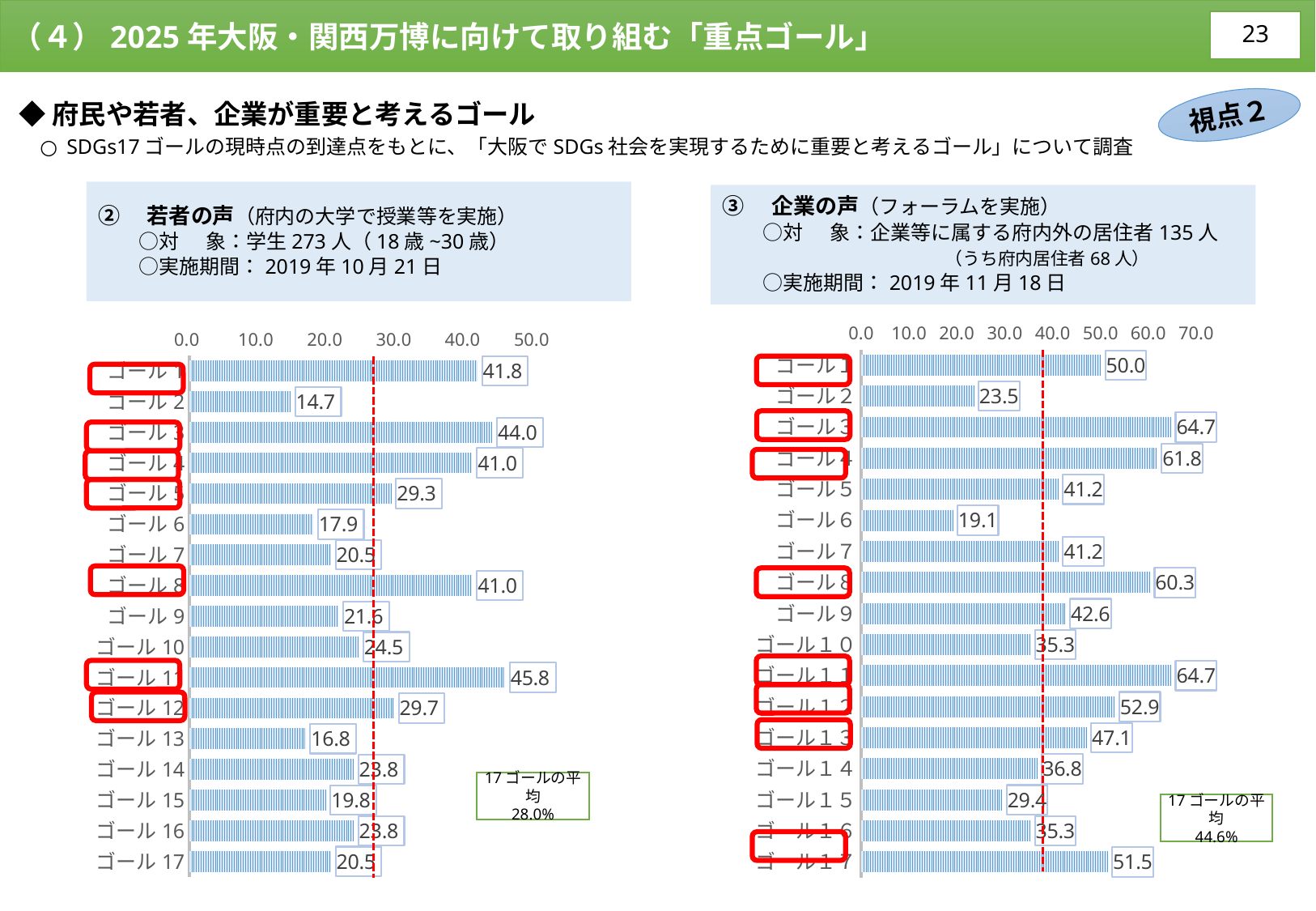
In the 若者の声 chart on the left, which goal has the highest value? ゴール 11 In the 若者の声 chart on the left, which goal has the lowest value? ゴール 2 In the 企業の声 chart on the right, which goal has the lowest value? ゴール 6 In the 若者の声 chart on the left, what is the value for ゴール 11? 45.8 In the 若者の声 chart on the left, which is larger, the value for ゴール 3 or the value for ゴール 5? ゴール 3 In the 企業の声 chart on the right, is the value for ゴール 12 greater or less than 40.0? greater In the 若者の声 chart on the left, what is the average of the 17 goals shown in the green box? 28.0% In the 企業の声 chart on the right, what is the difference between the values for ゴール 3 and ゴール 2? 41.2 How many goals (categories) are plotted in the 若者の声 chart on the left? 17 In the 企業の声 chart on the right, what is the average of the 17 goals shown in the green box? 44.6% What kind of chart is the 企業の声 chart on the right? bar chart In the 企業の声 chart on the right, what is the value for ゴール 8? 60.3